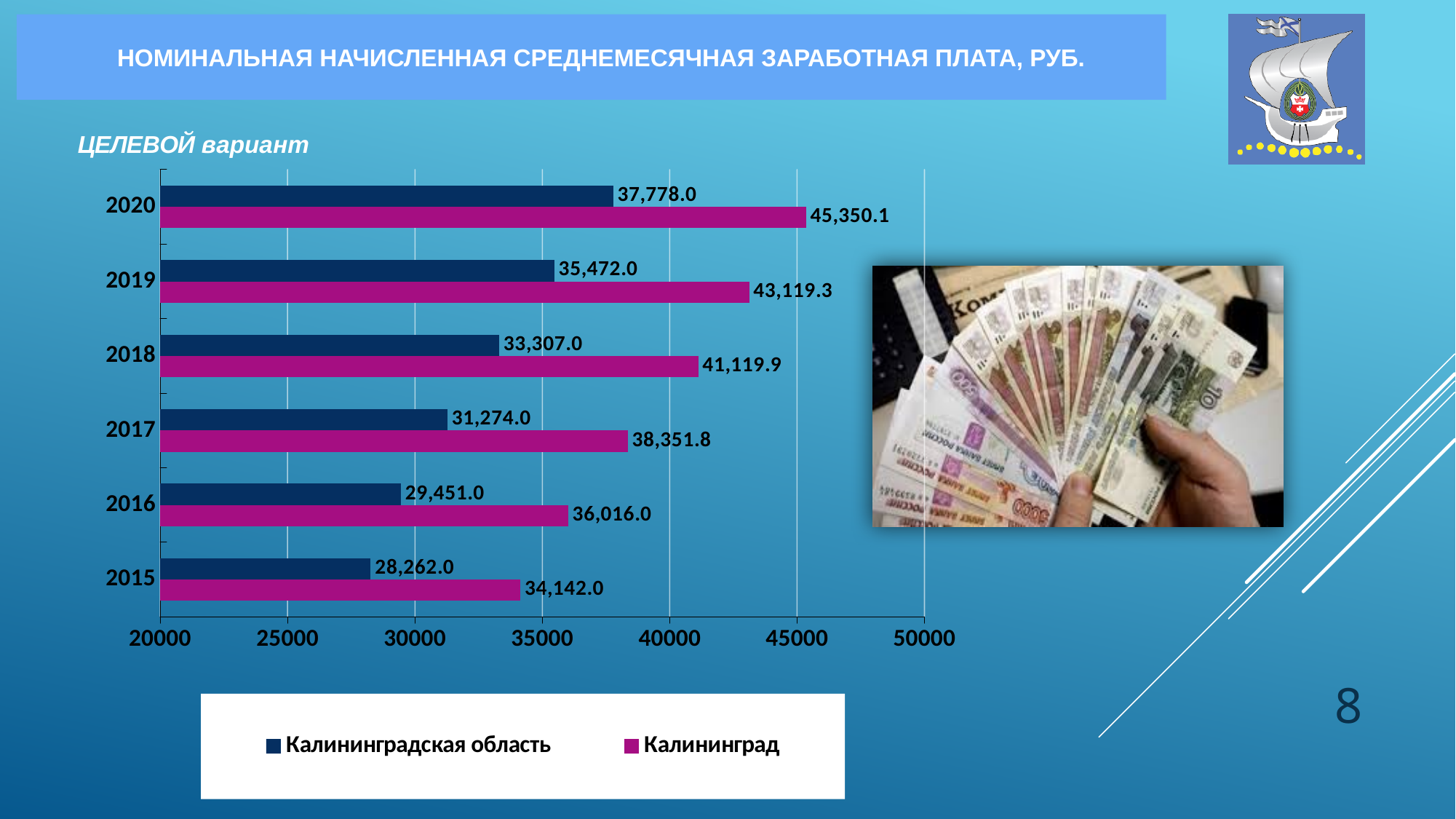
What is the difference between the Калининград and Калининградская область values in 2020? 7,572.1 What is the value for Калининград in 2017? 38,351.8 Which year has the highest value for Калининград? 2020 By how much did the value for Калининград increase from 2015 to 2020? 11,208.1 What is the value for Калининградская область in 2020? 37,778.0 How many years are shown on the chart? 6 Which is larger in 2018: the value for Калининград or for Калининградская область? Калининград Do the values for Калининградская область rise or fall from 2015 to 2020? Rise What is the value for Калининградская область in 2015? 28,262.0 Which year has the lowest value for Калининградская область? 2015 How many series does the legend list? 2 What kind of chart is shown on the slide? Bar chart